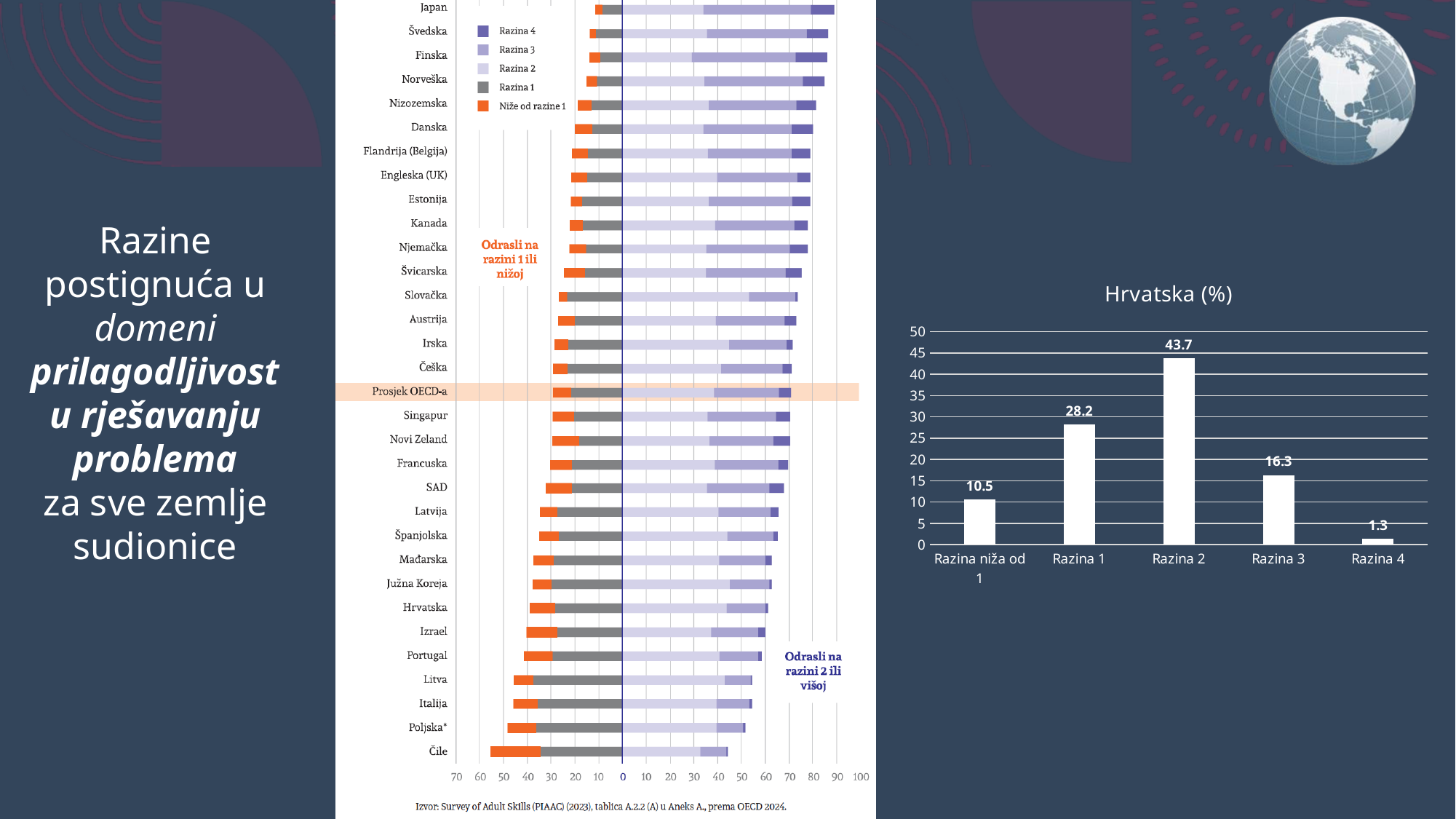
In the 'Hrvatska (%)' chart, what is the value for Razina 4? 1.3 In the large chart on the left, which country is listed at the bottom of the chart? Čile In the 'Hrvatska (%)' chart, what is the value for Razina niža od 1? 10.5 In the 'Hrvatska (%)' chart, which category has the highest value? Razina 2 In the 'Hrvatska (%)' chart, what is the value for Razina 2? 43.7 In the 'Hrvatska (%)' chart, which is larger: Razina 1 or Razina 3? Razina 1 In the 'Hrvatska (%)' chart, how many categories are shown? 5 What kind of chart is the 'Hrvatska (%)' chart? Bar chart In the 'Hrvatska (%)' chart, which category has the lowest value? Razina 4 In the large chart on the left, how many series does the legend list? 5 In the large chart on the left, is the value for Čile on the 'Odrasli na razini 1 ili nižoj' side greater or less than 50? greater In the 'Hrvatska (%)' chart, what is the difference between Razina 1 and Razina 3? 11.9